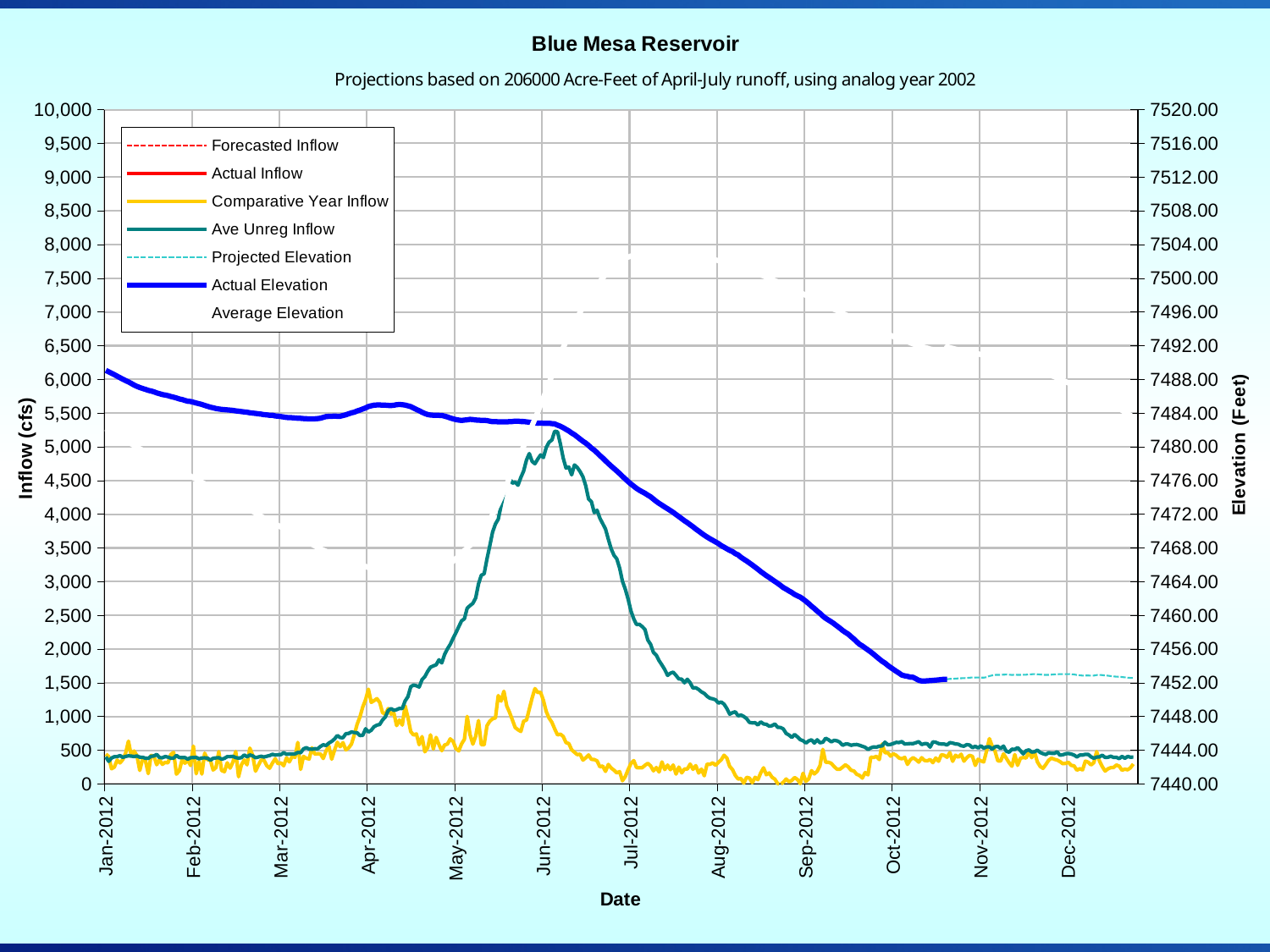
What kind of chart is shown on the slide? Line chart Is the Actual Elevation at Jan-2012 greater or less than 7484.00 feet? greater Does the Actual Elevation line rise or fall between Jun-2012 and Oct-2012? Fall What is the title of the chart? Blue Mesa Reservoir How many series does the legend list? 7 Is the Actual Elevation at Oct-2012 greater or less than 7456.00 feet? less At Jun-2012, which is larger: the Ave Unreg Inflow or the Comparative Year Inflow? Ave Unreg Inflow How many month labels are shown along the x axis? 12 Is the highest value of the Comparative Year Inflow line greater or less than 2,000 cfs? less What is the label of the right-hand vertical axis? Elevation (Feet) In which month does the Ave Unreg Inflow line reach its peak? Jun-2012